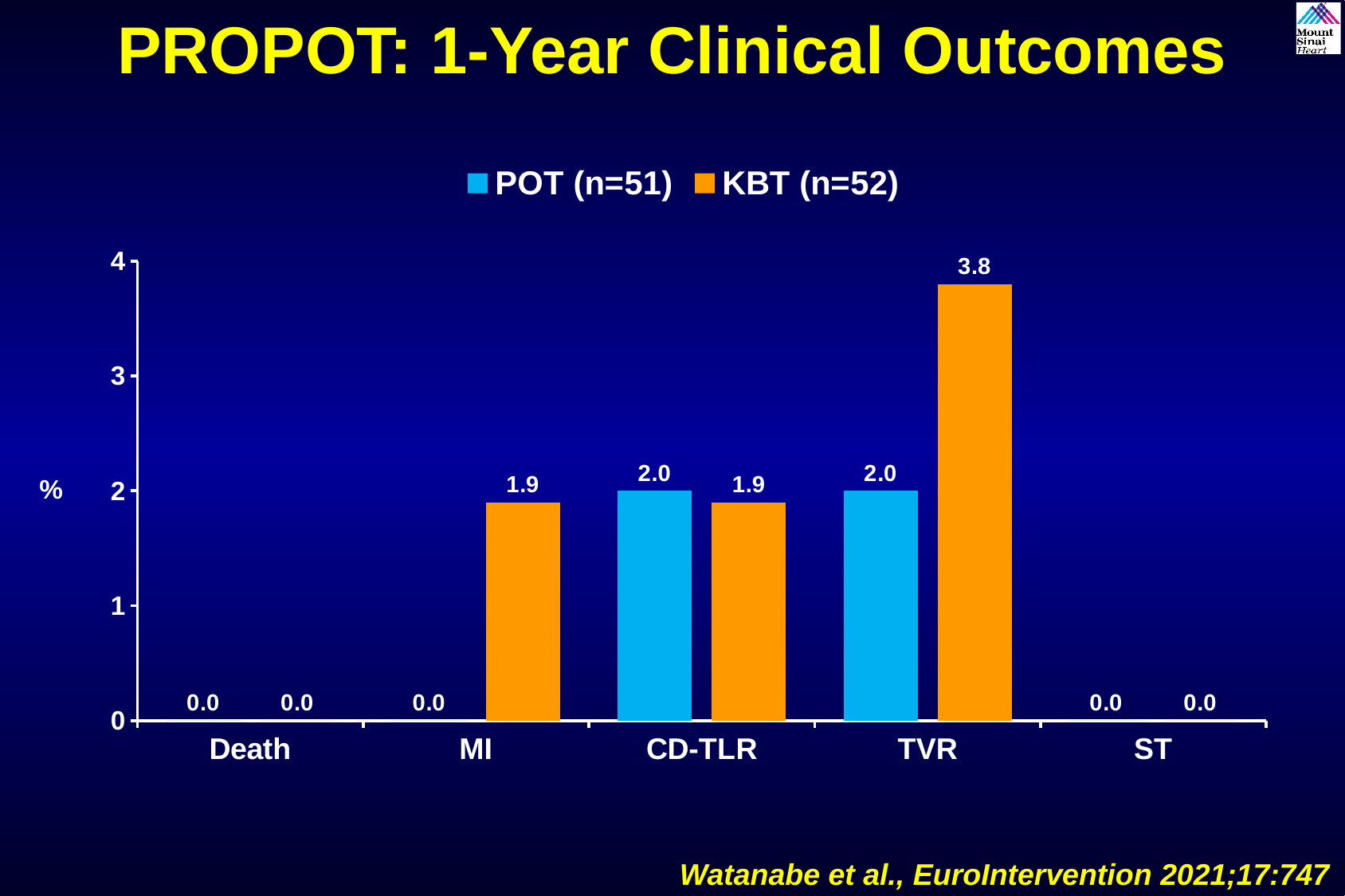
How many categories are shown on the x axis? 5 What is the KBT (n=52) value for MI? 1.9 How many series does the legend list? 2 Which category has the highest KBT (n=52) value? TVR Which is larger for CD-TLR, the POT (n=51) value or the KBT (n=52) value? POT (n=51) What is the title of the slide? PROPOT: 1-Year Clinical Outcomes What is the difference between the KBT (n=52) and POT (n=51) values for TVR? 1.8 What kind of chart is shown on the slide? bar chart What is the POT (n=51) value for MI? 0.0 What is the POT (n=51) value for CD-TLR? 2.0 What is the KBT (n=52) value for TVR? 3.8 Is the KBT (n=52) value for TVR greater or less than 3? greater